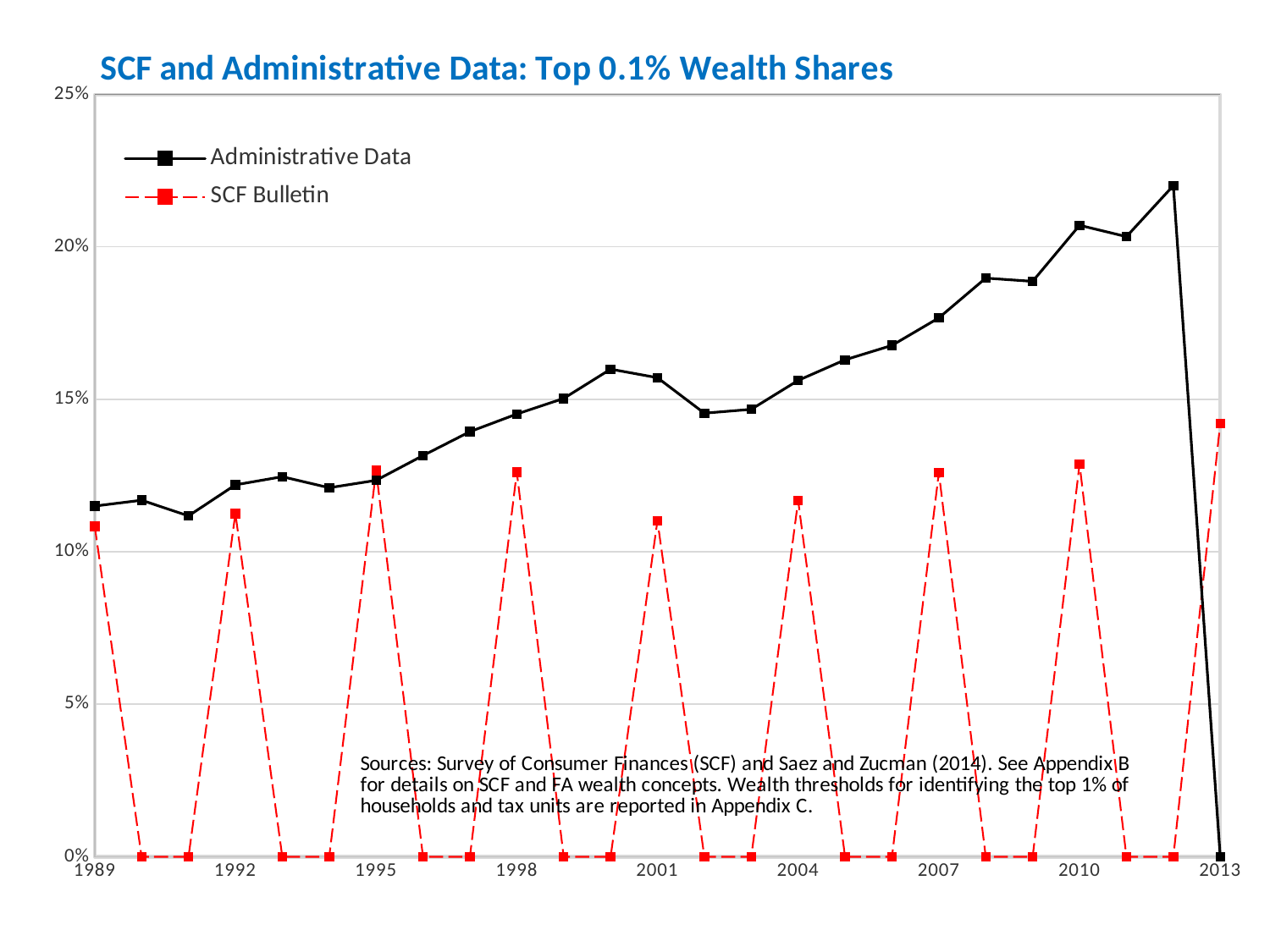
Is the Administrative Data value for 2012 greater or less than 20%? greater Which series has the higher value in 2013, Administrative Data or SCF Bulletin? SCF Bulletin Does the Administrative Data series generally rise or fall between 1989 and 2012? rise Is the Administrative Data value for 1989 greater or less than 15%? less What kind of chart is shown on the slide? line chart What are the two series named in the legend? Administrative Data and SCF Bulletin How many series does the legend list? 2 Is the Administrative Data value for 2007 greater or less than 15%? greater In which year does the Administrative Data series reach its highest value? 2012 What is the title of the chart? SCF and Administrative Data: Top 0.1% Wealth Shares